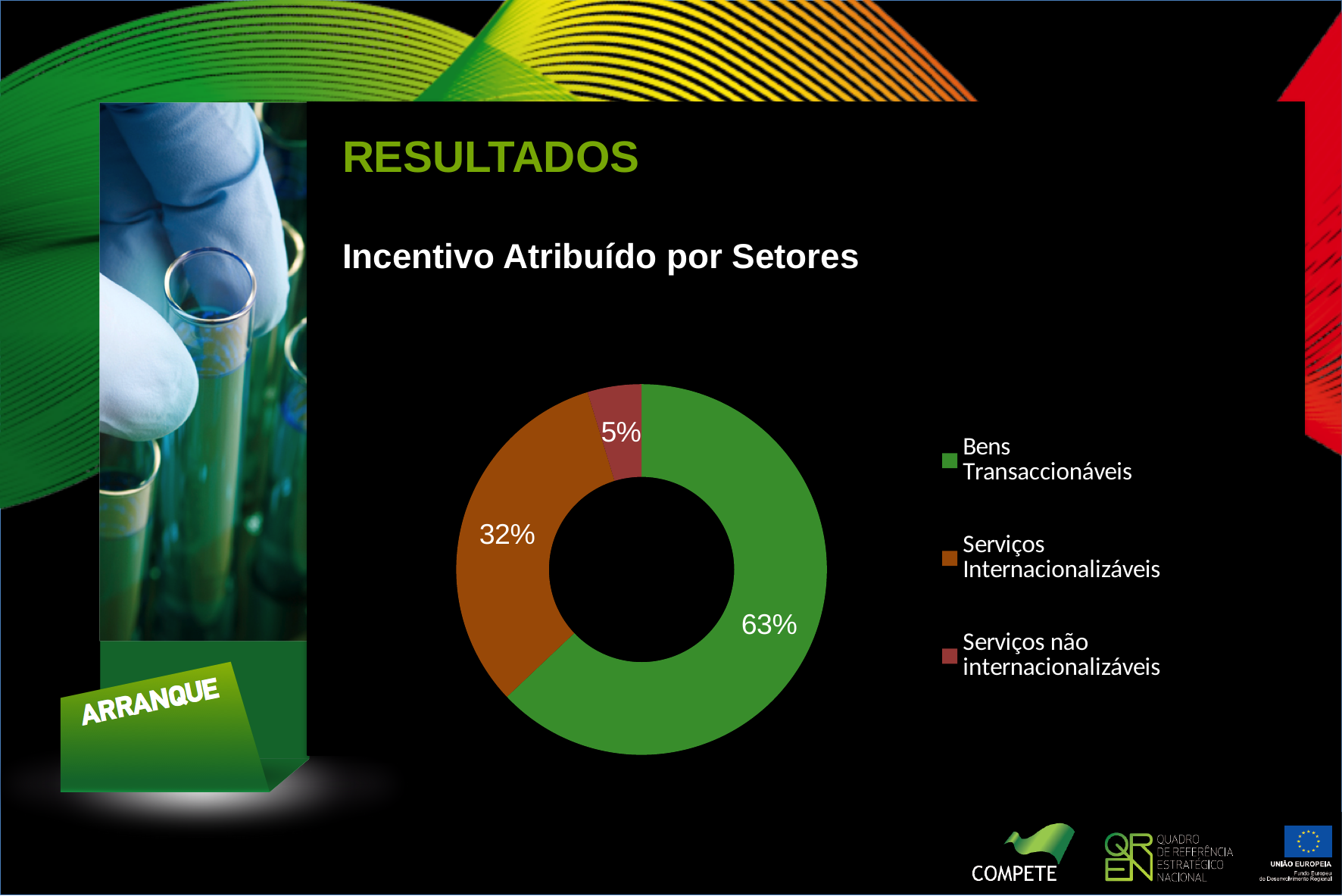
Which sector receives the smallest share of the incentive? Serviços não internacionalizáveis What is the title of the chart? Incentivo Atribuído por Setores What colour represents Serviços Internacionalizáveis in the chart? Brown/orange What share of the incentive goes to Serviços não internacionalizáveis? 5% Which sector receives the largest share of the incentive? Bens Transaccionáveis How many sectors are shown in the chart? 3 What share of the incentive goes to Serviços Internacionalizáveis? 32% What is the difference in percentage points between Bens Transaccionáveis and Serviços Internacionalizáveis? 31 Which is larger: the share for Serviços Internacionalizáveis or for Serviços não internacionalizáveis? Serviços Internacionalizáveis What kind of chart is shown on the slide? Doughnut (pie) chart What is the combined share of Serviços Internacionalizáveis and Serviços não internacionalizáveis? 37% What share of the incentive goes to Bens Transaccionáveis? 63%